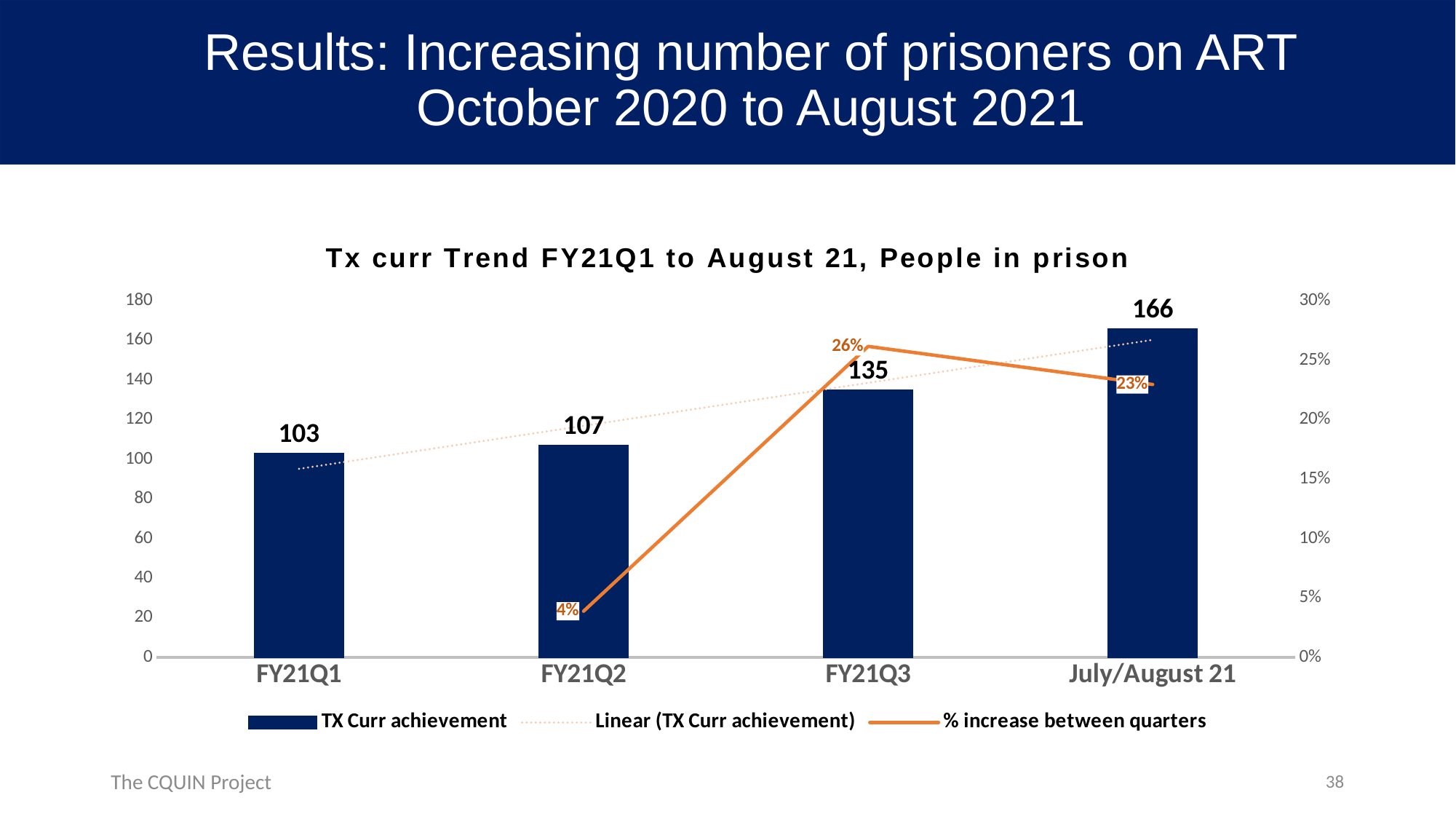
Which is larger, the TX Curr achievement for FY21Q2 or for FY21Q3? FY21Q3 Which period has the lowest TX Curr achievement? FY21Q1 What is the title of the chart? Tx curr Trend FY21Q1 to August 21, People in prison Do the TX Curr achievement values rise or fall from FY21Q1 to July/August 21? rise What is the % increase between quarters shown for FY21Q3? 26% What is the TX Curr achievement value for FY21Q3? 135 What is the % increase between quarters shown for July/August 21? 23% What is the TX Curr achievement value for FY21Q1? 103 How many periods are shown on the x axis? 4 How many series does the legend list? 3 Which period has the highest TX Curr achievement? July/August 21 What is the difference in TX Curr achievement between July/August 21 and FY21Q3? 31